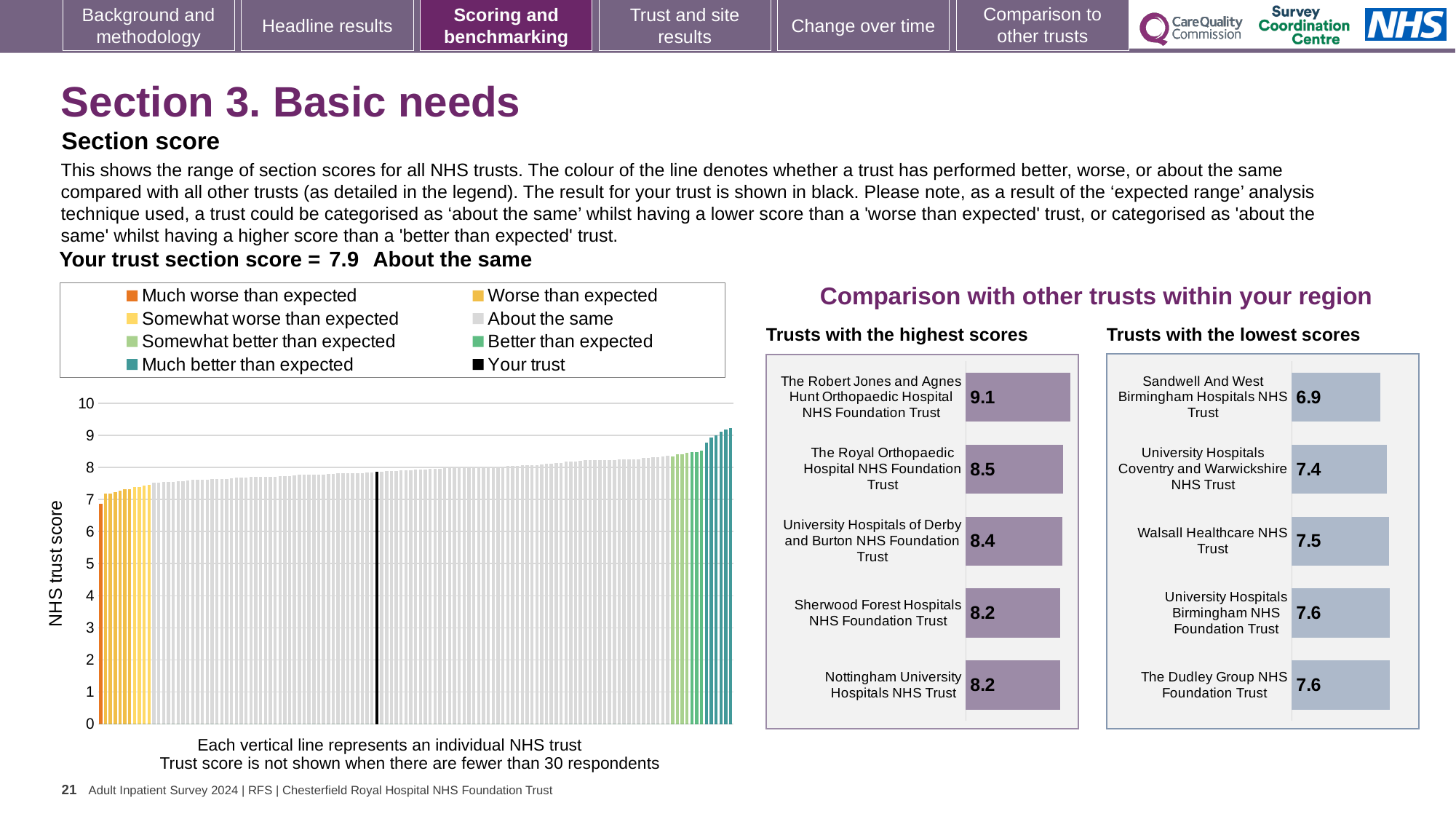
What kind of chart is the main section score chart on the left of the slide? Bar chart On the 'Trusts with the lowest scores' chart, what is the score for Walsall Healthcare NHS Trust? 7.5 On the main section score chart, do the trust scores rise or fall from left to right? Rise What is the section score for your trust shown on the slide? 7.9 On the 'Trusts with the highest scores' chart, what is the score for The Robert Jones and Agnes Hunt Orthopaedic Hospital NHS Foundation Trust? 9.1 On the 'Trusts with the highest scores' chart, which has the higher score: The Royal Orthopaedic Hospital NHS Foundation Trust or University Hospitals of Derby and Burton NHS Foundation Trust? The Royal Orthopaedic Hospital NHS Foundation Trust On the 'Trusts with the highest scores' chart, what is the difference between the scores of The Robert Jones and Agnes Hunt Orthopaedic Hospital NHS Foundation Trust and The Royal Orthopaedic Hospital NHS Foundation Trust? 0.6 On the 'Trusts with the lowest scores' chart, what is the difference between the scores of The Dudley Group NHS Foundation Trust and Sandwell And West Birmingham Hospitals NHS Trust? 0.7 How many trusts are shown on the 'Trusts with the lowest scores' chart? 5 On the 'Trusts with the lowest scores' chart, which trust has the lowest score? Sandwell And West Birmingham Hospitals NHS Trust How many entries does the legend of the main section score chart list? 8 On the 'Trusts with the highest scores' chart, which trust has the highest score? The Robert Jones and Agnes Hunt Orthopaedic Hospital NHS Foundation Trust